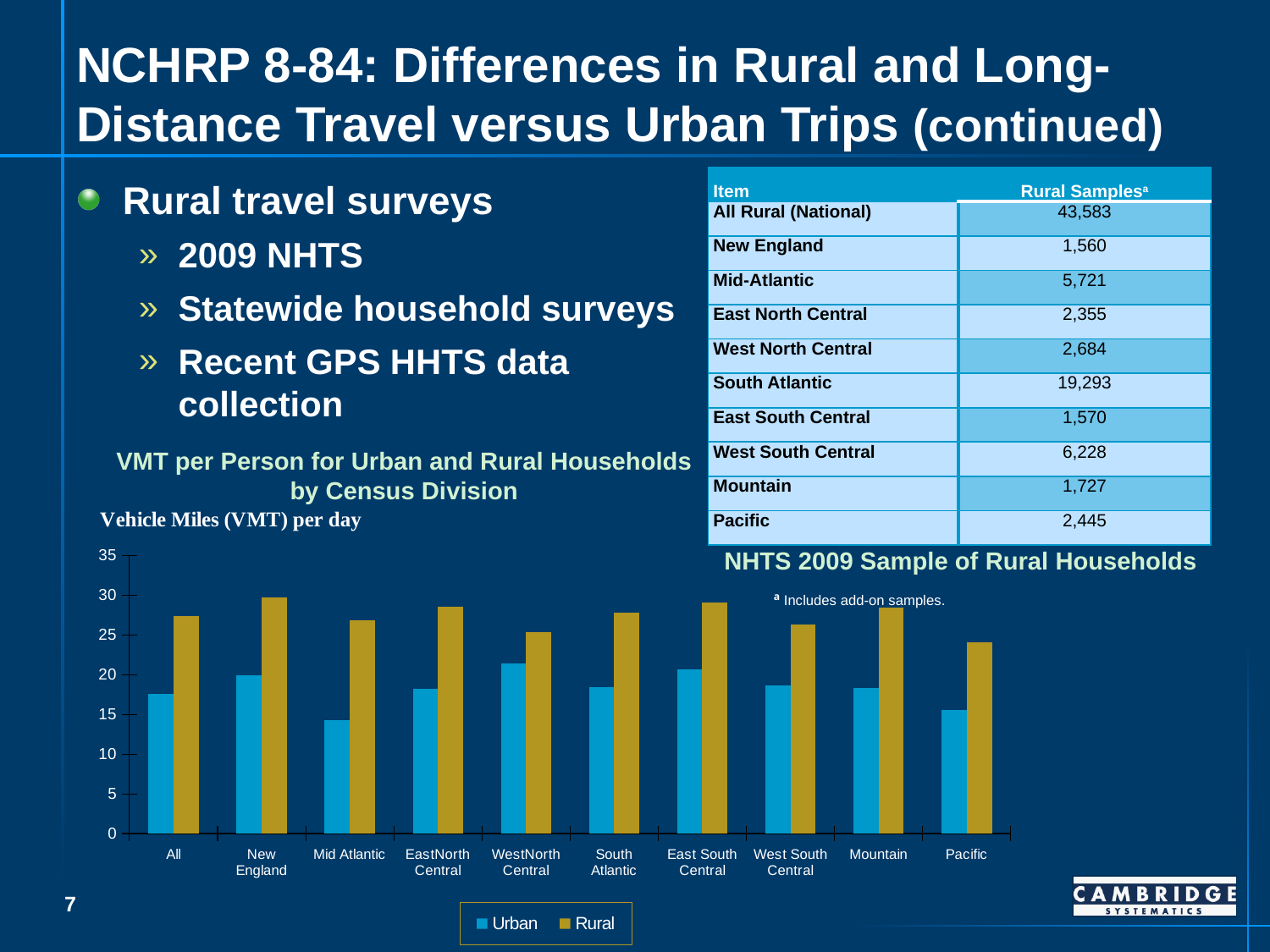
In the VMT per Person chart, is the Urban value for West North Central greater or less than 20? greater In the VMT per Person chart, is the Urban value for All greater or less than 20? less In the VMT per Person chart, is the Urban value for Mid Atlantic greater or less than 15? less Which census division has the lowest Rural VMT per person in the chart? Pacific How many series does the legend of the VMT per Person chart list? 2 What kind of chart is shown on the slide? bar chart Which census division has the lowest Urban VMT per person in the chart? Mid Atlantic What is the label on the vertical axis of the VMT per Person chart? Vehicle Miles (VMT) per day How many census division categories are shown on the x axis of the VMT per Person chart? 10 In the VMT per Person chart, which is larger for South Atlantic, the Urban or the Rural value? Rural